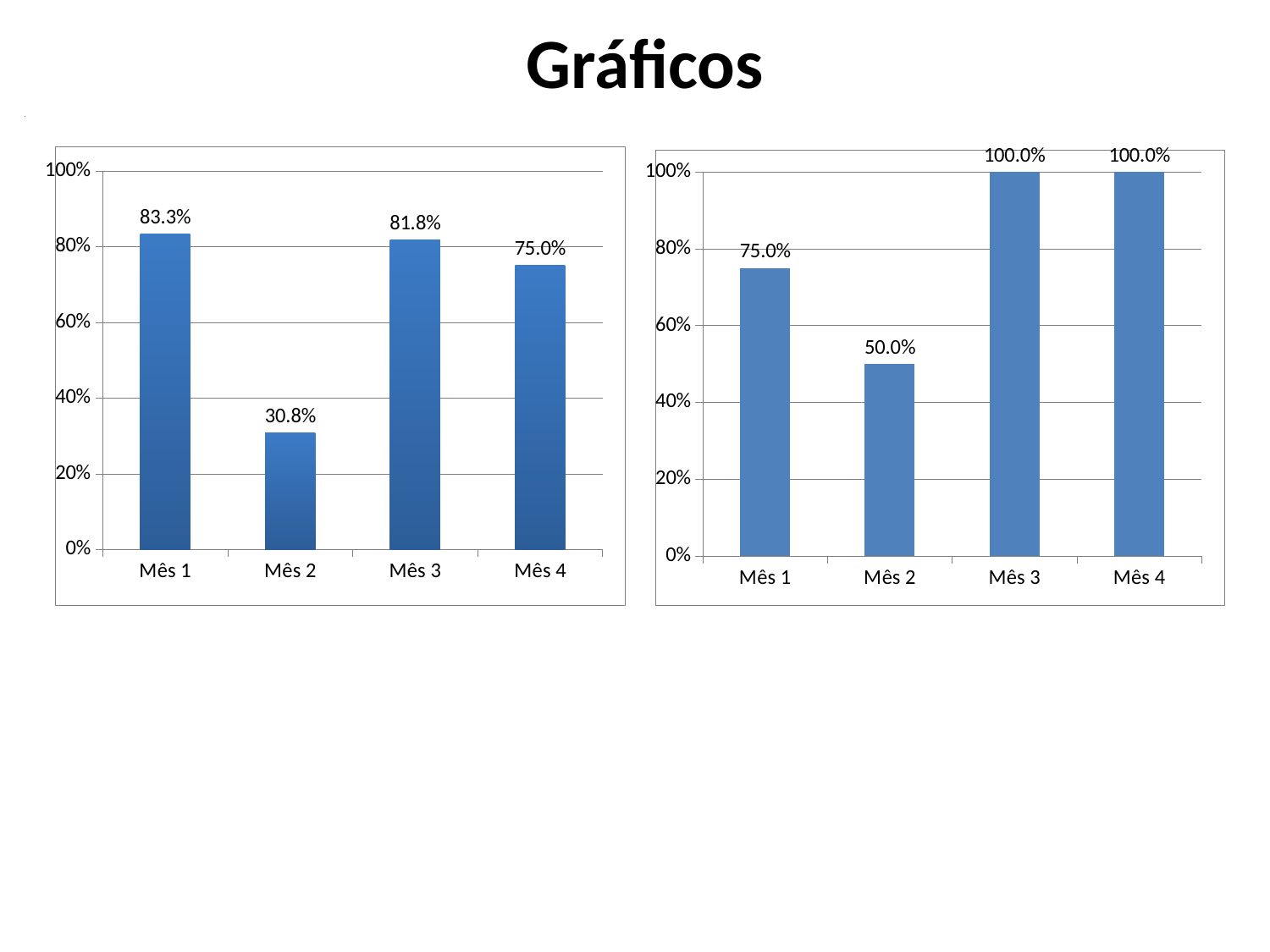
In the left chart, which month has the highest value? Mês 1 What kind of chart is the left chart? Bar chart In the left chart, what is the value for Mês 2? 30.8% In the left chart, what is the difference between the values for Mês 1 and Mês 2? 52.5% In the left chart, which is larger, the value for Mês 3 or the value for Mês 4? Mês 3 In the right chart, what is the value for Mês 1? 75.0% How many months are shown on the x axis of the right chart? 4 In the left chart, which month has the lowest value? Mês 2 In the right chart, what is the difference between the values for Mês 3 and Mês 1? 25.0% In the right chart, what is the value for Mês 2? 50.0% In the right chart, which month has the lowest value? Mês 2 In the left chart, what is the value for Mês 1? 83.3%